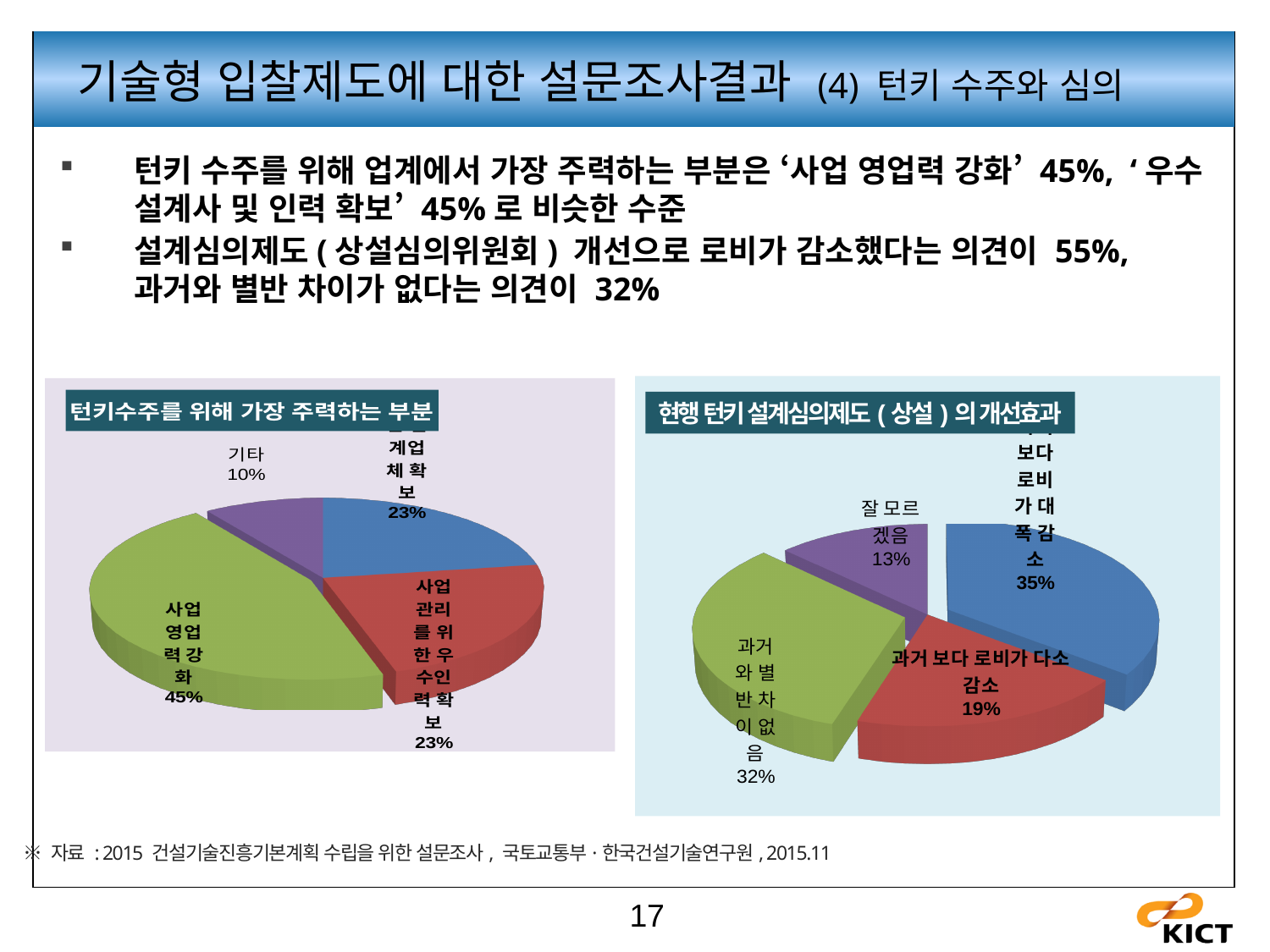
In the left pie chart '턴키수주를 위해 가장 주력하는 부분', how many slices does the pie have? 4 In the right pie chart '현행 턴키 설계심의제도 (상설)의 개선효과', what colour is the slice for '잘 모르겠음'? Purple In the right pie chart '현행 턴키 설계심의제도 (상설)의 개선효과', what percentage is shown for '과거와 별반 차이 없음'? 32% In the left pie chart '턴키수주를 위해 가장 주력하는 부분', what is the difference in percentage points between '사업 영업력 강화' and '사업 관리를 위한 우수인력 확보'? 22 In the right pie chart '현행 턴키 설계심의제도 (상설)의 개선효과', which is larger: '과거와 별반 차이 없음' or '과거 보다 로비가 다소 감소'? 과거와 별반 차이 없음 In the right pie chart '현행 턴키 설계심의제도 (상설)의 개선효과', what percentage is shown for '과거 보다 로비가 다소 감소'? 19% In the left pie chart '턴키수주를 위해 가장 주력하는 부분', which category has the largest share? 사업 영업력 강화 What type of chart is used on the right side of the slide, '현행 턴키 설계심의제도 (상설)의 개선효과'? Pie chart In the left pie chart '턴키수주를 위해 가장 주력하는 부분', which category has the smallest share? 기타 In the right pie chart '현행 턴키 설계심의제도 (상설)의 개선효과', which category has the smallest share? 잘 모르겠음 In the left pie chart '턴키수주를 위해 가장 주력하는 부분', what percentage is shown for '기타'? 10% In the left pie chart '턴키수주를 위해 가장 주력하는 부분', what percentage is shown for '사업 영업력 강화'? 45%